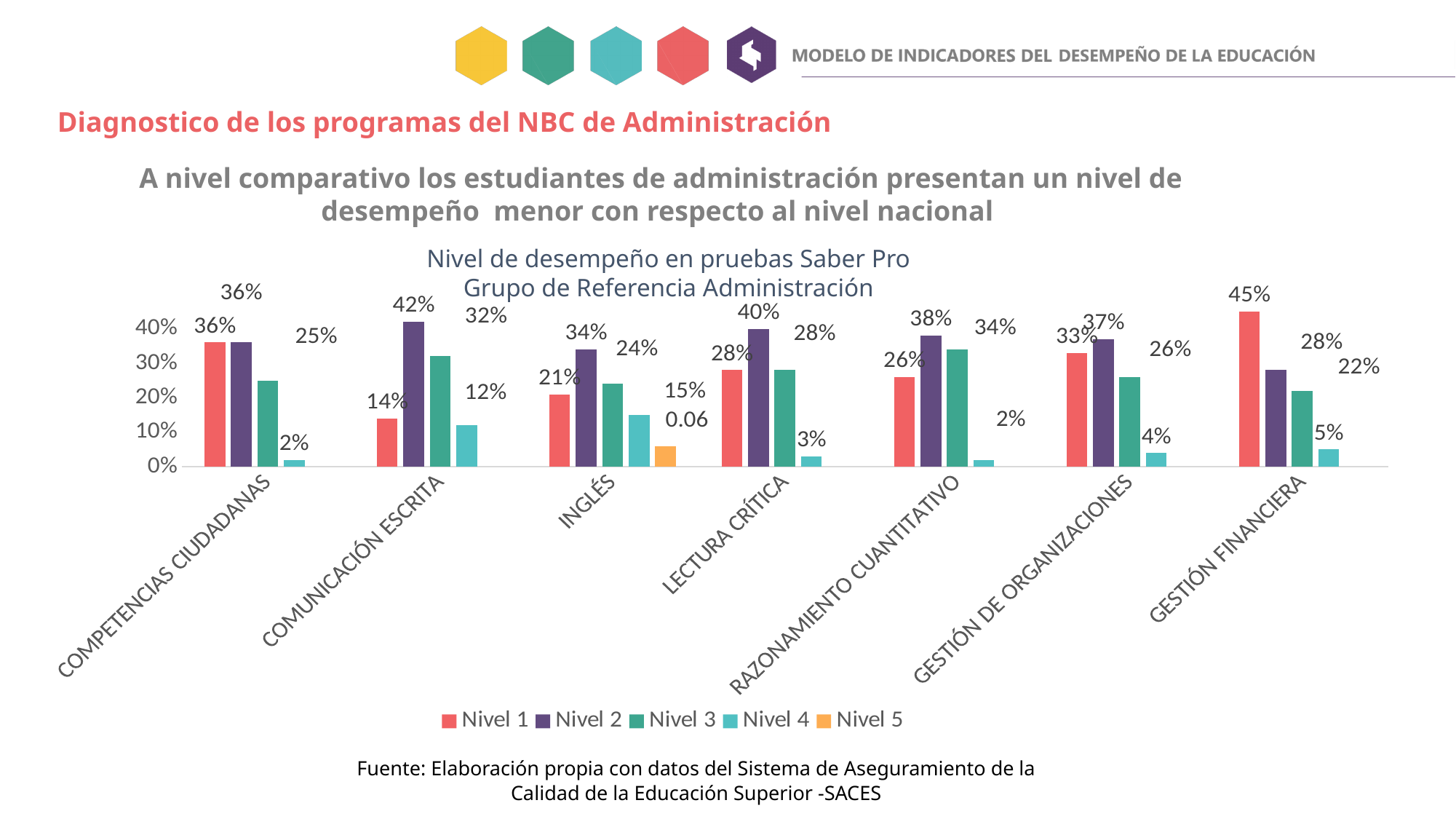
How many categories are shown on the x axis? 7 What is the Nivel 2 value for COMUNICACIÓN ESCRITA? 42% Which has the larger Nivel 3 value, RAZONAMIENTO CUANTITATIVO or GESTIÓN DE ORGANIZACIONES? RAZONAMIENTO CUANTITATIVO What is the Nivel 4 value for INGLÉS? 15% Which category has the highest Nivel 1 value? GESTIÓN FINANCIERA How many series does the legend list? 5 Which category is the only one with a Nivel 5 bar? INGLÉS Which category has the lowest Nivel 1 value? COMUNICACIÓN ESCRITA What kind of chart is shown on the slide? bar chart What is the Nivel 5 value for INGLÉS? 0.06 What is the difference between the Nivel 2 and Nivel 1 values for COMUNICACIÓN ESCRITA? 28 percentage points What is the Nivel 1 value for GESTIÓN FINANCIERA? 45%